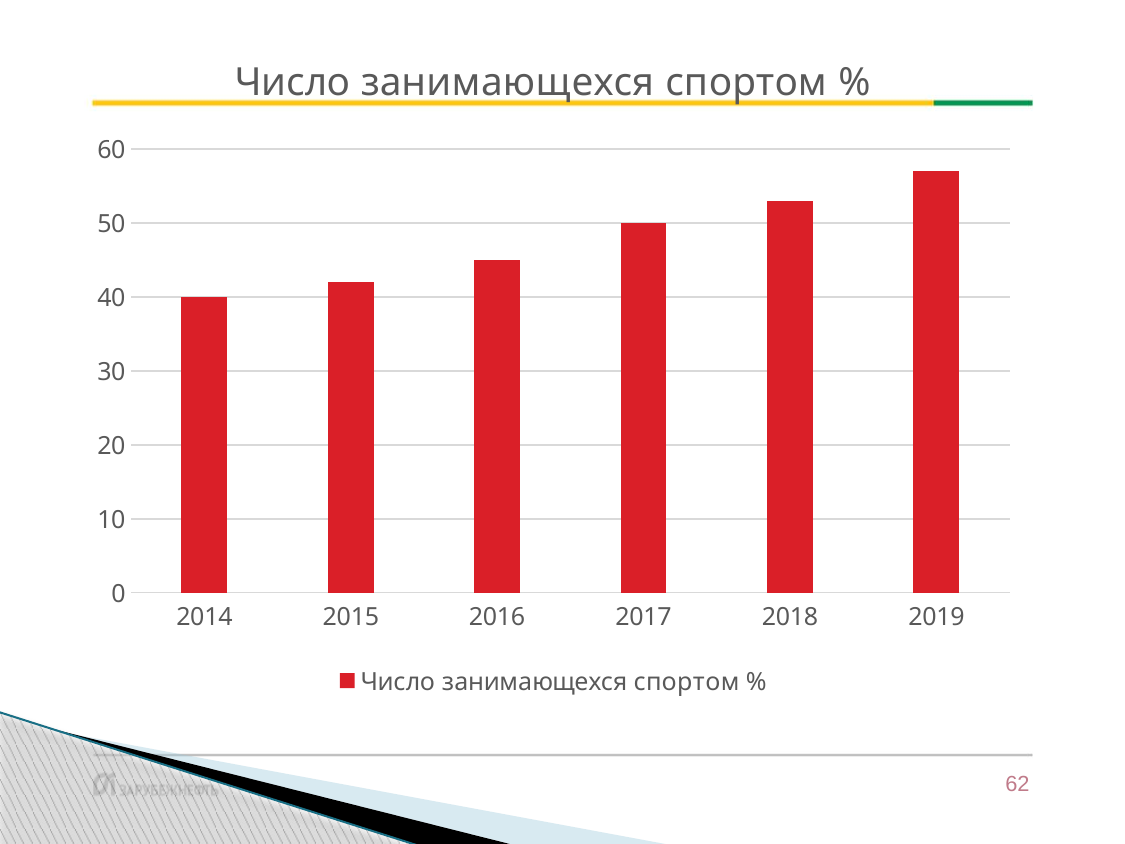
How many years are shown on the x axis of the chart? 6 Is the value for 2016 greater or less than 50? less Is the value for 2019 greater or less than 50? greater Do the values rise or fall from 2014 to 2019? rise What is the value for 2014? 40 What type of chart is shown on the slide? bar chart What is the title of the chart? Число занимающехся спортом % How many series does the legend list? 1 Which is larger, the value for 2015 or the value for 2018? 2018 Which year has the highest value? 2019 Which year has the lowest value? 2014 What is the value for 2017? 50